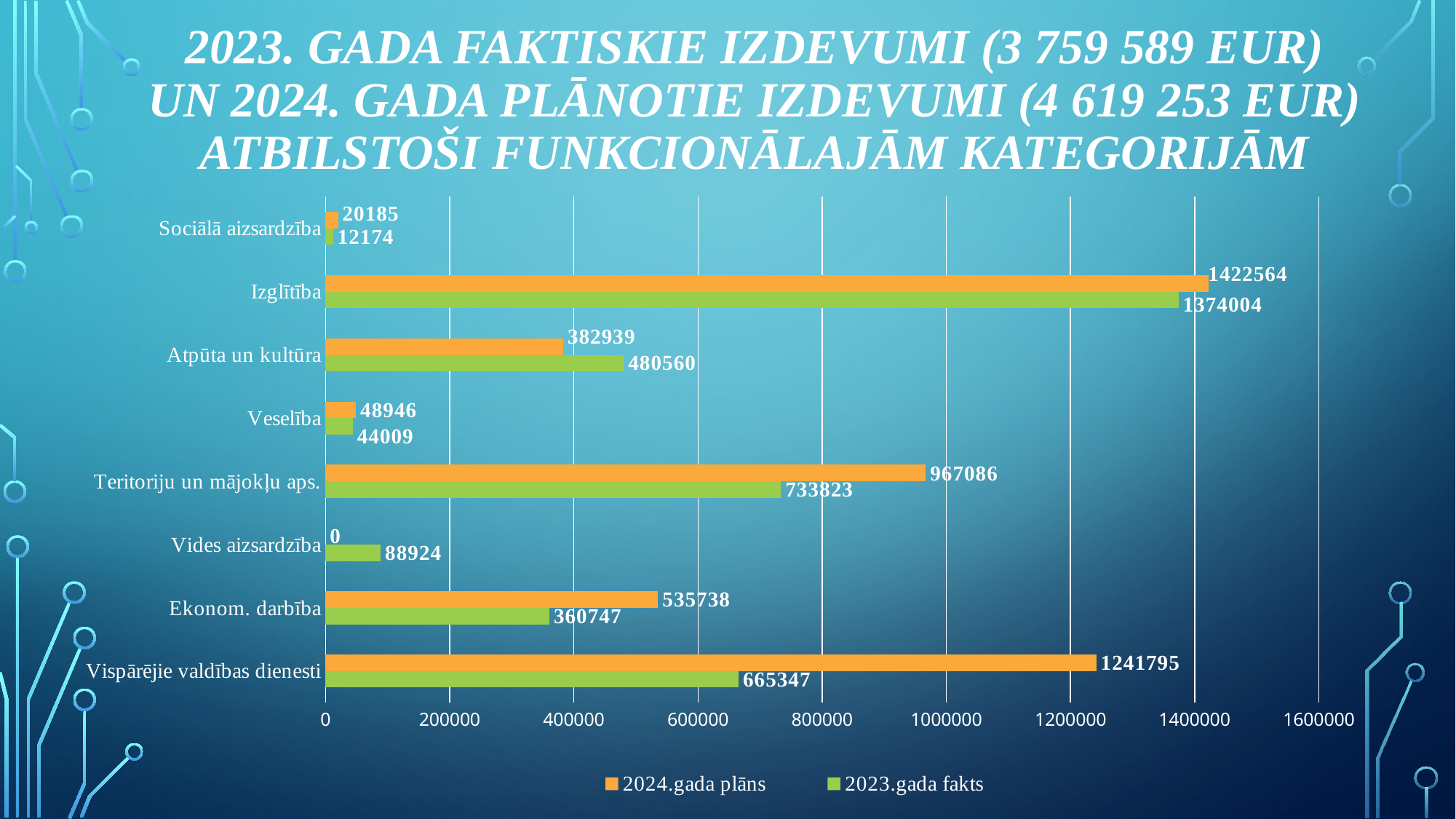
How many categories are shown on the chart? 8 For Atpūta un kultūra, which is larger: the 2024.gada plāns value or the 2023.gada fakts value? 2023.gada fakts What type of chart is shown on the slide? bar chart What is the 2024.gada plāns value for Izglītība? 1422564 How many series does the legend list? 2 What is the 2023.gada fakts value for Vispārējie valdības dienesti? 665347 Which category has the lowest 2023.gada fakts value? Sociālā aizsardzība Which colour represents the 2024.gada plāns series? orange What is the 2024.gada plāns value for Vides aizsardzība? 0 Which category has the highest 2023.gada fakts value? Izglītība What is the difference between the 2024.gada plāns and 2023.gada fakts values for Vispārējie valdības dienesti? 576448 What is the difference between the 2023.gada fakts and 2024.gada plāns values for Atpūta un kultūra? 97621